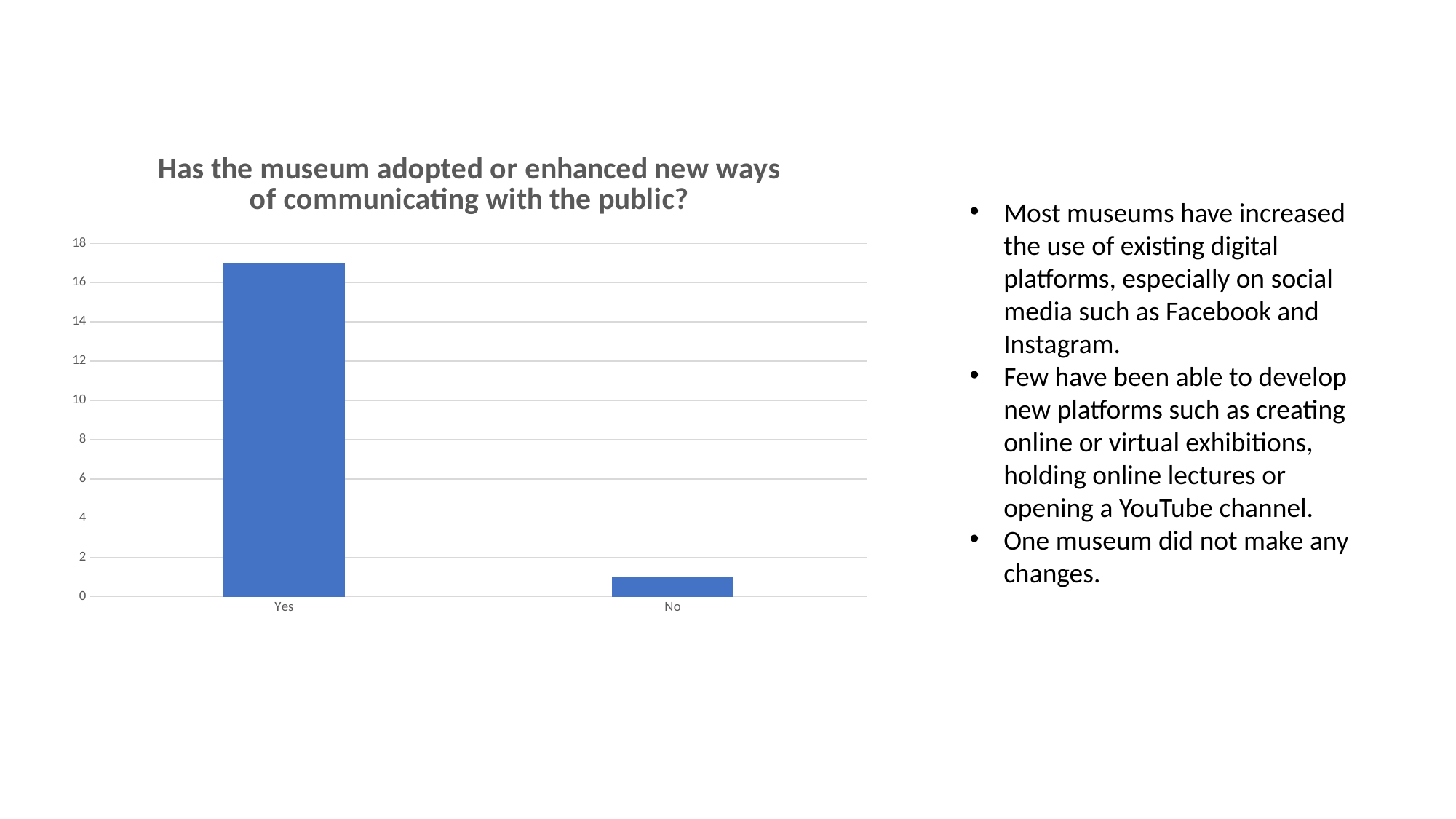
How many categories are shown on the x axis of the chart? 2 Is the value for Yes greater or less than 10? greater Which category has the highest value in the chart? Yes Which is larger, the value for Yes or the value for No? Yes What is the highest value shown on the y axis of the chart? 18 Is the value for Yes greater or less than 16? greater What kind of chart is shown on the slide? bar chart What is the title of the chart? Has the museum adopted or enhanced new ways of communicating with the public? Is the value for No greater or less than 2? less Which category has the lowest value in the chart? No